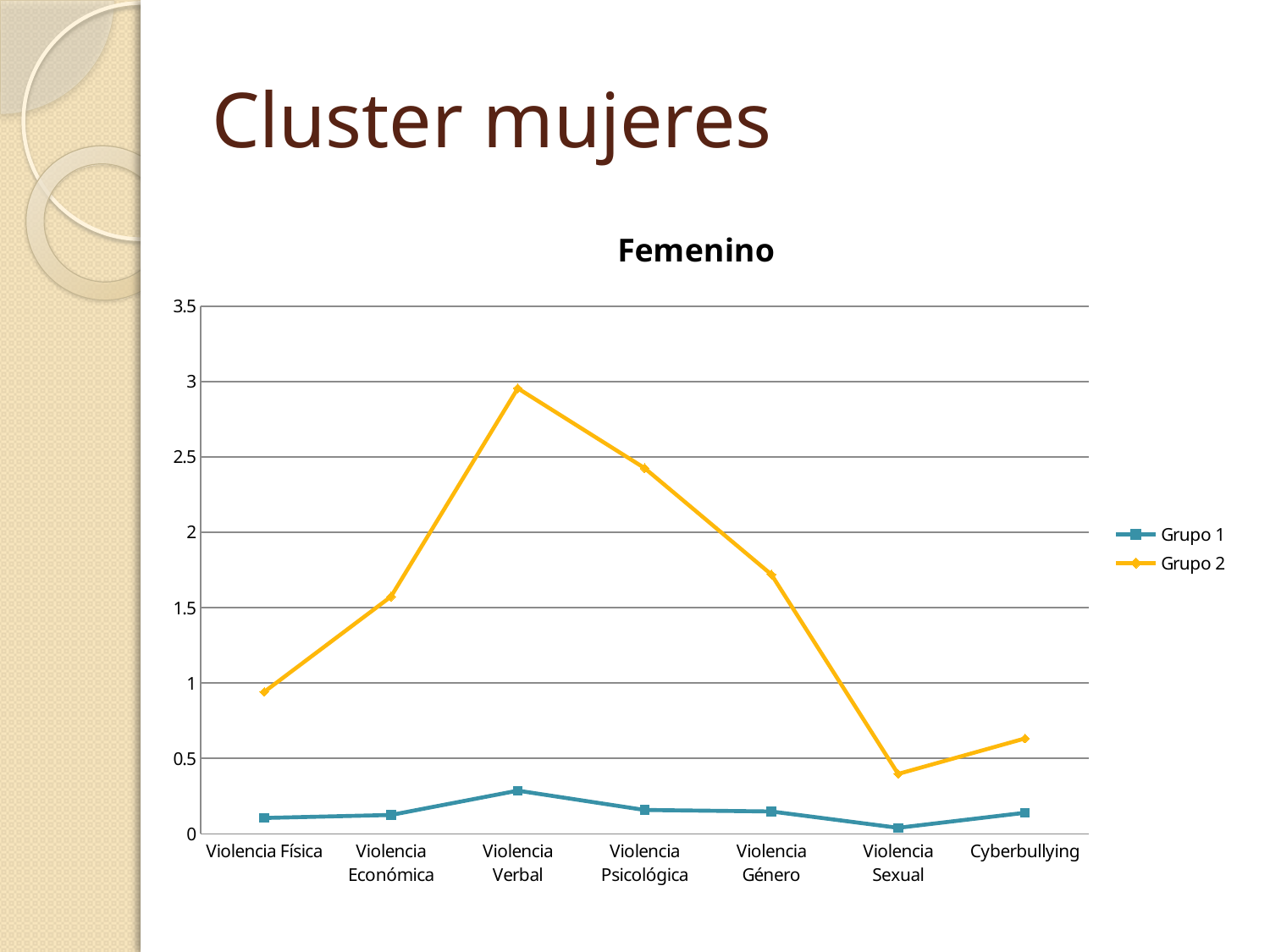
What is the title of the chart? Femenino Is the Grupo 2 value for Violencia Sexual greater or less than 0.5? less For Grupo 2, which category has the lowest value? Violencia Sexual How many series does the legend list? 2 How many categories are shown along the x axis? 7 What kind of chart is shown on the slide? line chart At Violencia Psicológica, which series has the larger value, Grupo 1 or Grupo 2? Grupo 2 Is the Grupo 2 value for Violencia Género greater or less than 1.5? greater For Grupo 2, which category has the highest value? Violencia Verbal For Grupo 2, do the values rise or fall from Violencia Verbal to Violencia Sexual? fall For Grupo 1, which category has the highest value? Violencia Verbal Is the Grupo 2 value for Violencia Verbal greater or less than 2.5? greater